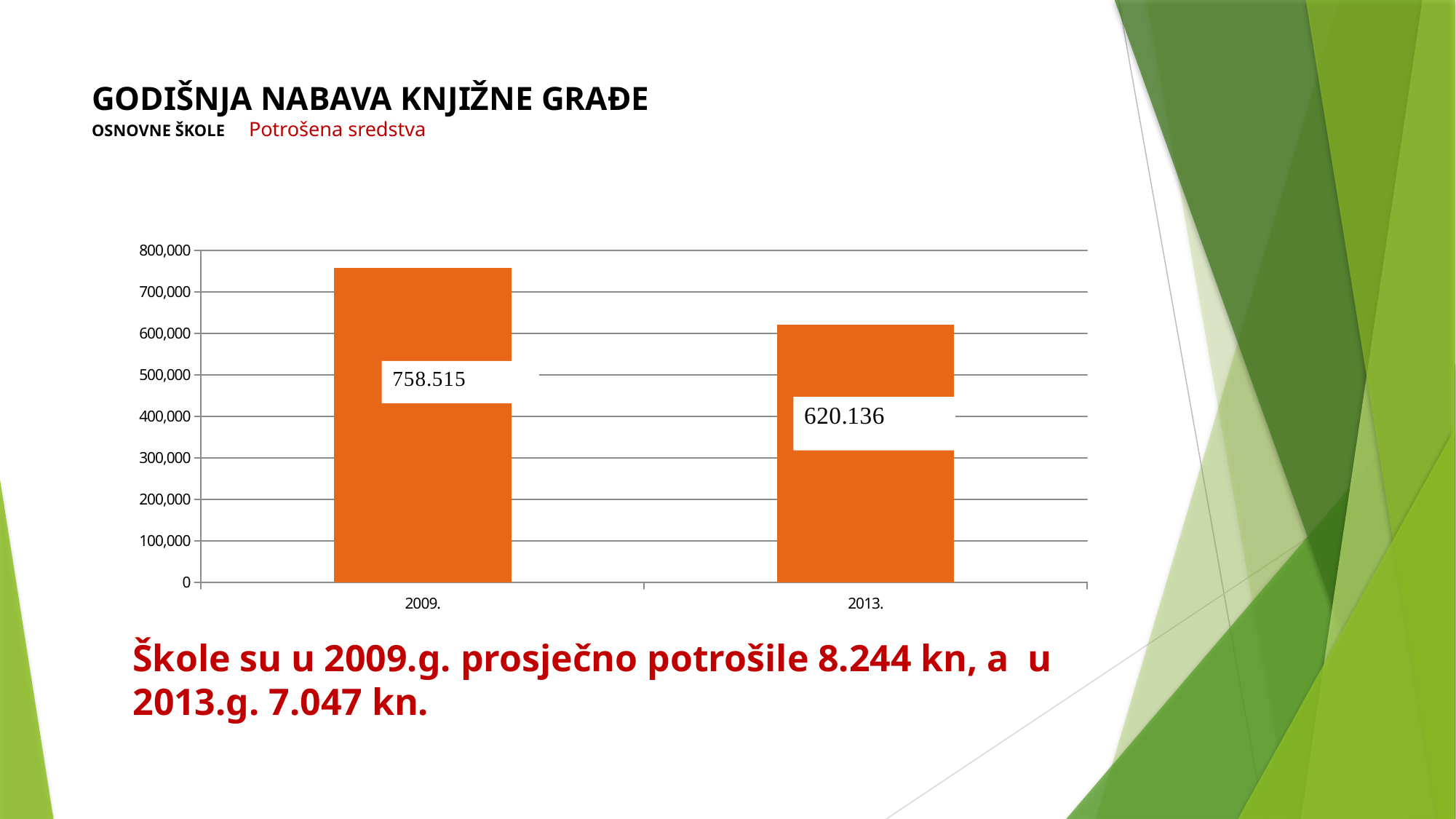
What kind of chart is shown on the slide? bar chart How many bars are plotted in the chart? 2 Is the value for 2009. greater or less than 700,000? greater What is the difference between the values for 2009. and 2013.? 138.379 Which year has the higher value? 2009. Do the values rise or fall from 2009. to 2013.? fall What is the value shown for 2009.? 758.515 Is the value for 2009. larger or smaller than the value for 2013.? larger Which year has the lower value? 2013. What colour are the bars in the chart? orange Is the value for 2013. greater or less than 700,000? less What is the value shown for 2013.? 620.136